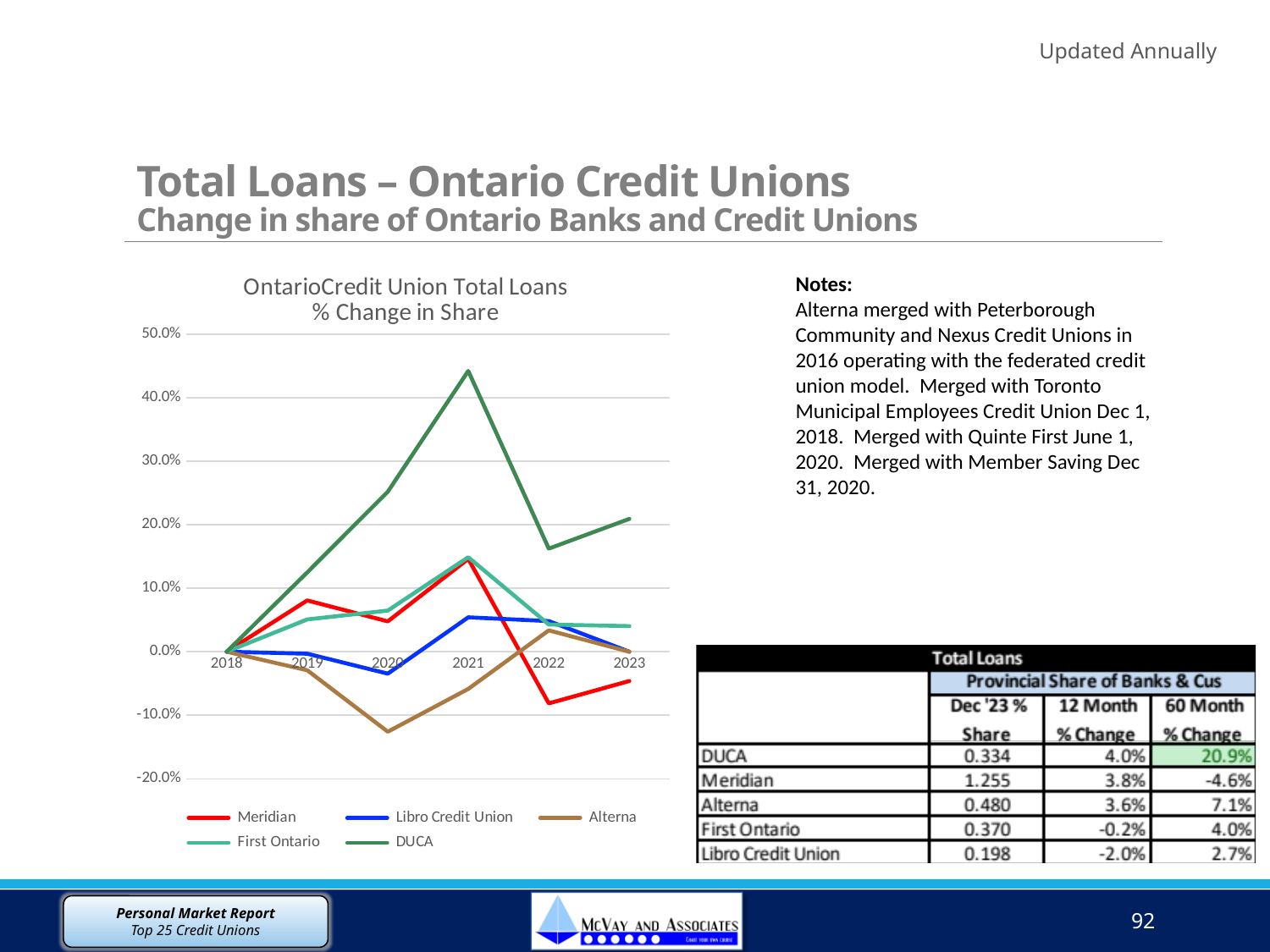
Which credit union has the lowest value in 2020? Alterna In 2022, which is larger: the value for Meridian or the value for DUCA? DUCA Is the value for DUCA in 2021 greater or less than 40.0%? greater How many years are plotted along the x axis of the chart? 6 What kind of chart is shown on the slide? line chart Does the Meridian line rise or fall from 2021 to 2022? fall Is the value for Alterna in 2020 greater or less than -10.0%? less Which credit union has the highest value in 2021? DUCA How many series does the chart legend list? 5 What colour is the Meridian line in the chart? red Is the value for DUCA in 2023 greater or less than 10.0%? greater Does the DUCA line rise or fall from 2018 to 2021? rise